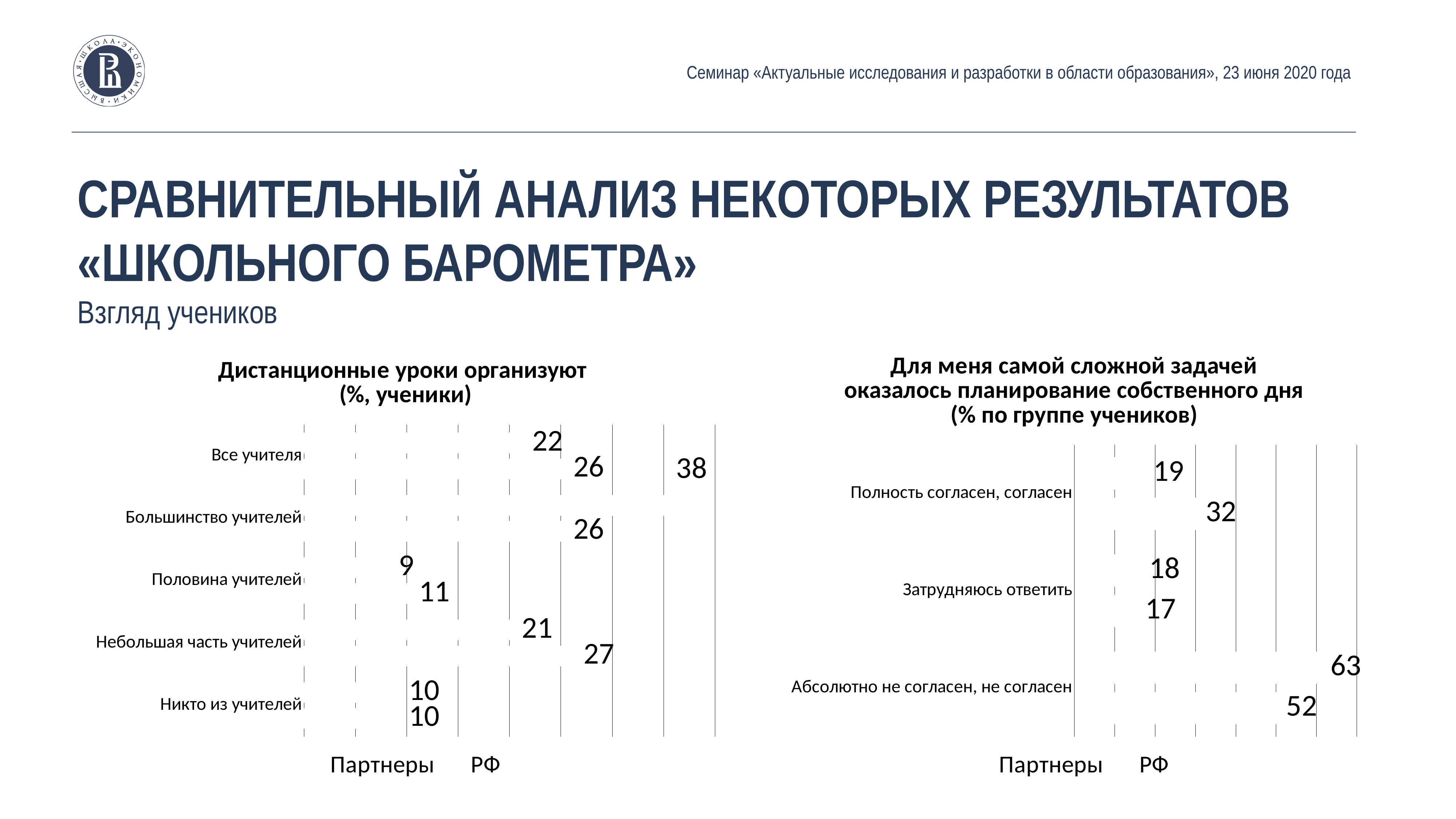
On the right chart, what is the largest value shown? 63 On the right chart, what are the two values shown for 'Полность согласен, согласен'? 19 and 32 On the left chart, what is the smallest value shown? 9 On the right chart, what are the two values shown for 'Затрудняюсь ответить'? 18 and 17 What kind of chart is the left chart, 'Дистанционные уроки организуют (%, ученики)'? bar chart On the right chart, what are the two values shown for 'Абсолютно не согласен, не согласен'? 63 and 52 What are the two series named in the legend of the left chart? Партнеры and РФ How many categories are shown on the right chart, 'Для меня самой сложной задачей оказалось планирование собственного дня'? 3 On the right chart, which category has the highest value? Абсолютно не согласен, не согласен On the left chart, what are the two values shown for 'Никто из учителей'? 10 and 10 How many categories are shown on the left chart, 'Дистанционные уроки организуют'? 5 How many series does the legend of the right chart list? 2